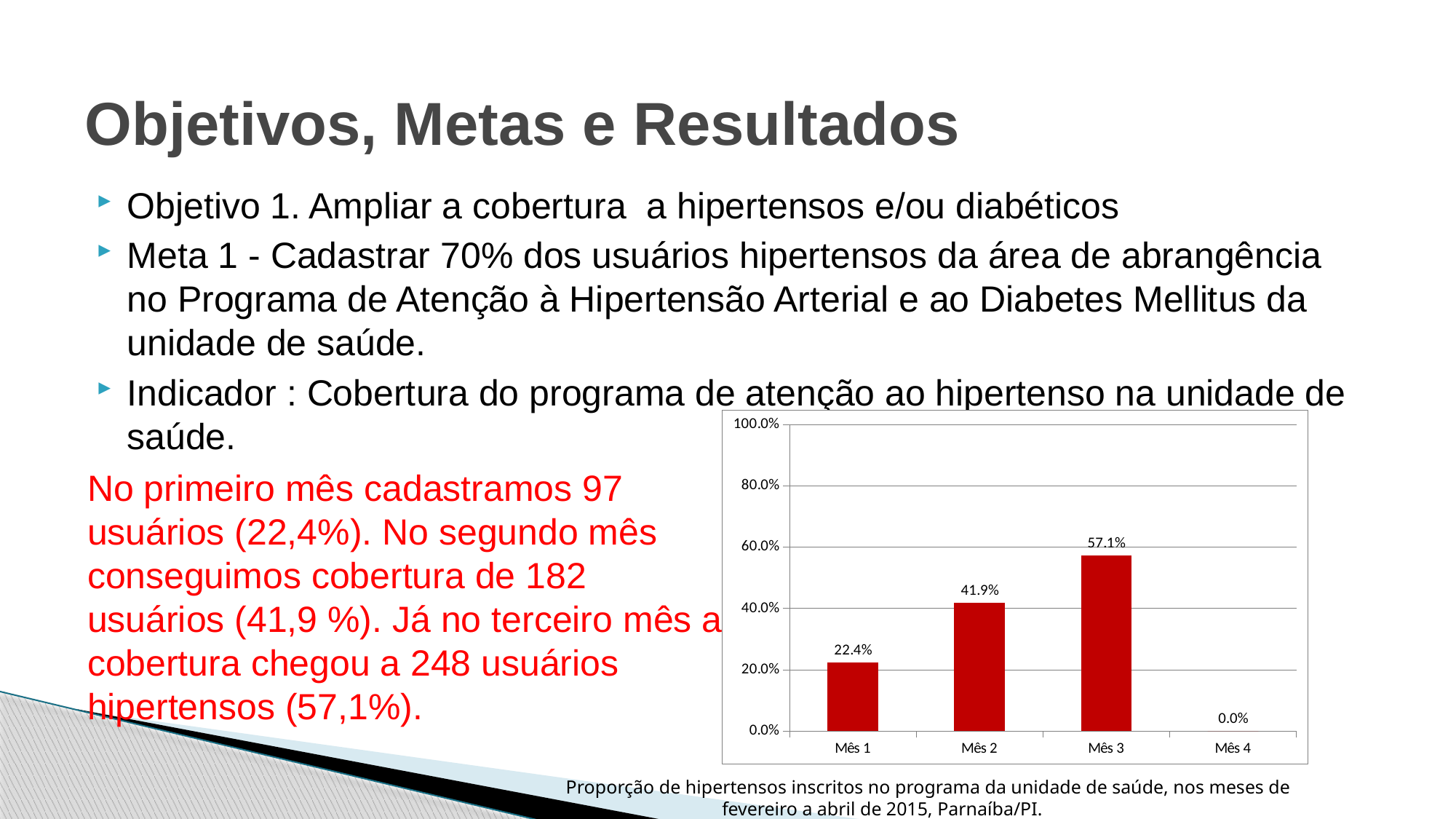
How many months are shown on the x axis? 4 Which is larger, the value for Mês 1 or the value for Mês 2? Mês 2 Which month has the lowest value? Mês 4 What is the difference between the values for Mês 2 and Mês 1? 19.5% What is the value for Mês 4? 0.0% Which month has the highest value? Mês 3 What kind of chart is shown on the slide? bar chart What is the value for Mês 3? 57.1% What is the value for Mês 1? 22.4% Is the value for Mês 3 greater or less than 60.0%? less What is the difference between the values for Mês 3 and Mês 2? 15.2% What is the value for Mês 2? 41.9%